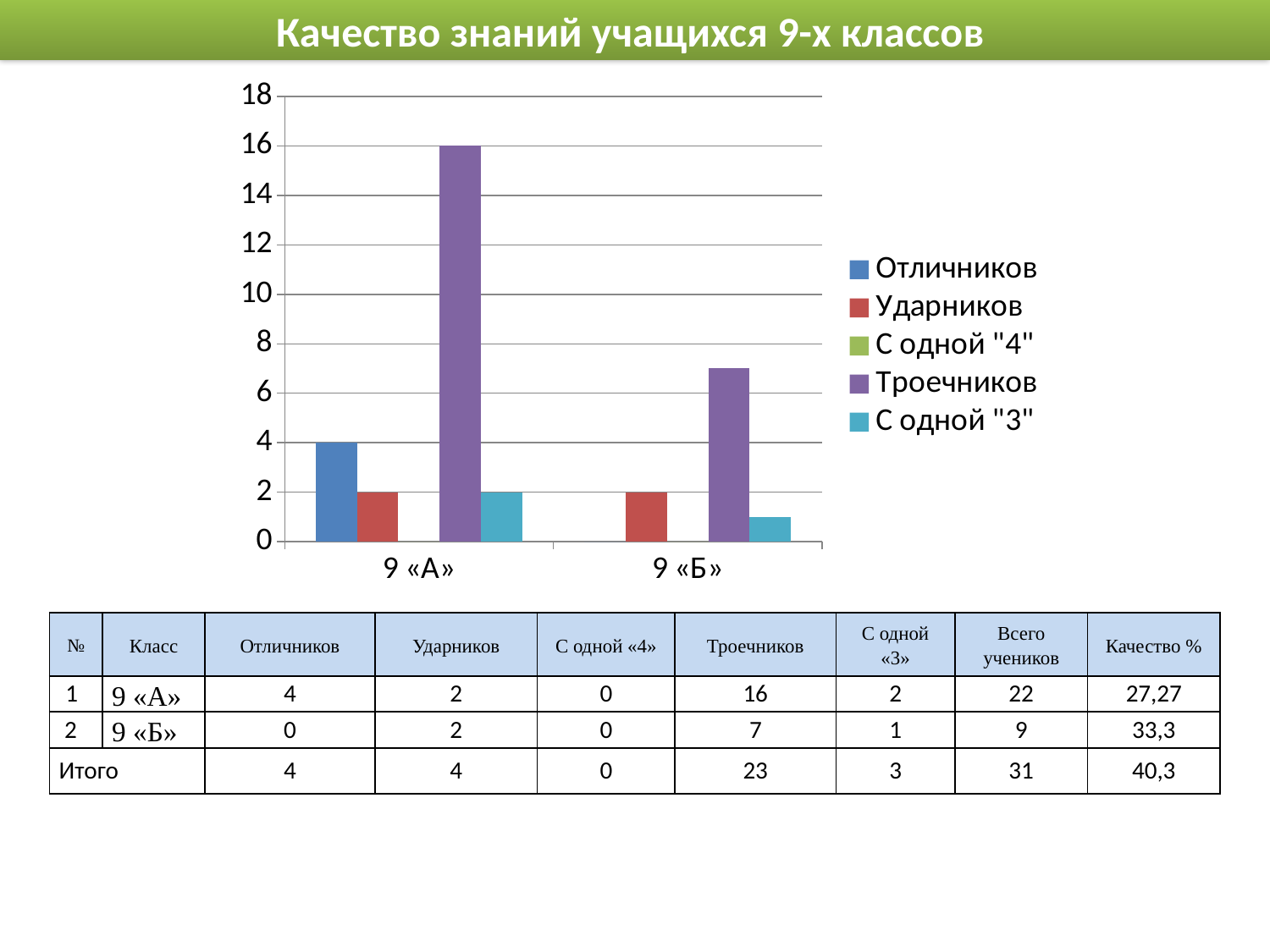
Which series has the highest value for 9 «А» in the chart? Троечников What kind of chart is shown on the slide? bar chart What is the difference between Троечников for 9 «А» and Троечников for 9 «Б»? 9 What is the value of С одной "3" for 9 «Б» in the chart? 1 Which is larger in the chart: Отличников for 9 «А» or Ударников for 9 «А»? Отличников for 9 «А» What is the value of Троечников for 9 «Б» in the chart? 7 What is the value of Отличников for 9 «А» in the chart? 4 Is the value of Троечников for 9 «Б» greater or less than 10? less What is the title of the slide containing the chart? Качество знаний учащихся 9-х классов How many series does the chart legend list? 5 How many classes (categories) are shown on the x axis of the chart? 2 What is the value of Троечников for 9 «А» in the chart? 16